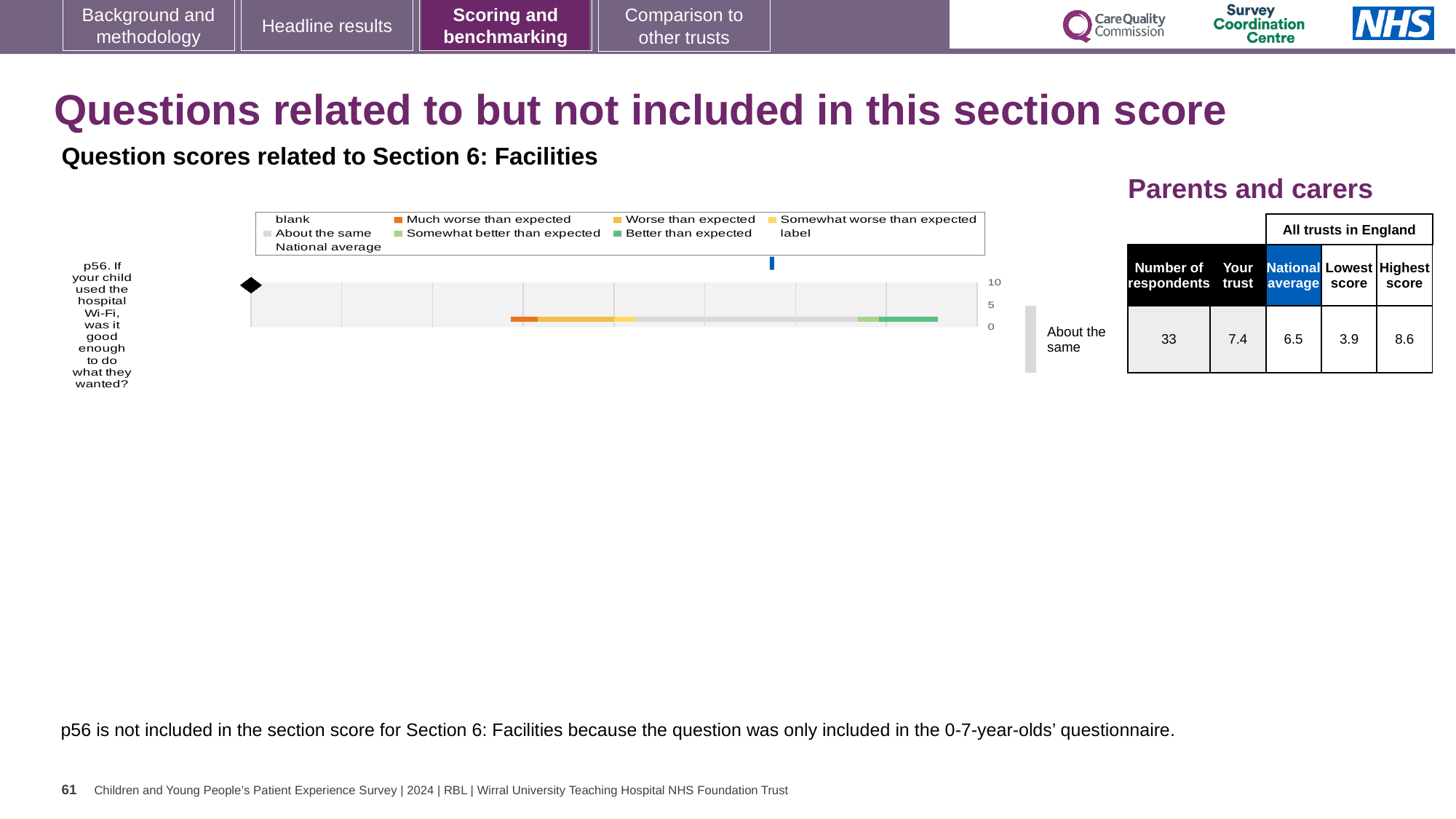
What kind of chart is shown on the slide? bar chart According to the table beside the chart, what is the 'Your trust' score for p56? 7.4 According to the table beside the chart, what is the lowest score among all trusts in England for p56? 3.9 What is the highest tick value shown on the chart's axis? 10 How many questions (categories) are plotted in the chart? 1 What benchmark category label is shown next to the chart for p56? About the same According to the table beside the chart, what is the national average score for p56? 6.5 Is the 'Your trust' score for p56 higher or lower than the national average? higher According to the table beside the chart, what is the highest score among all trusts in England for p56? 8.6 According to the table beside the chart, how many respondents answered p56? 33 How many entries does the chart legend list? 9 Which question is plotted in the chart? p56. If your child used the hospital Wi-Fi, was it good enough to do what they wanted?